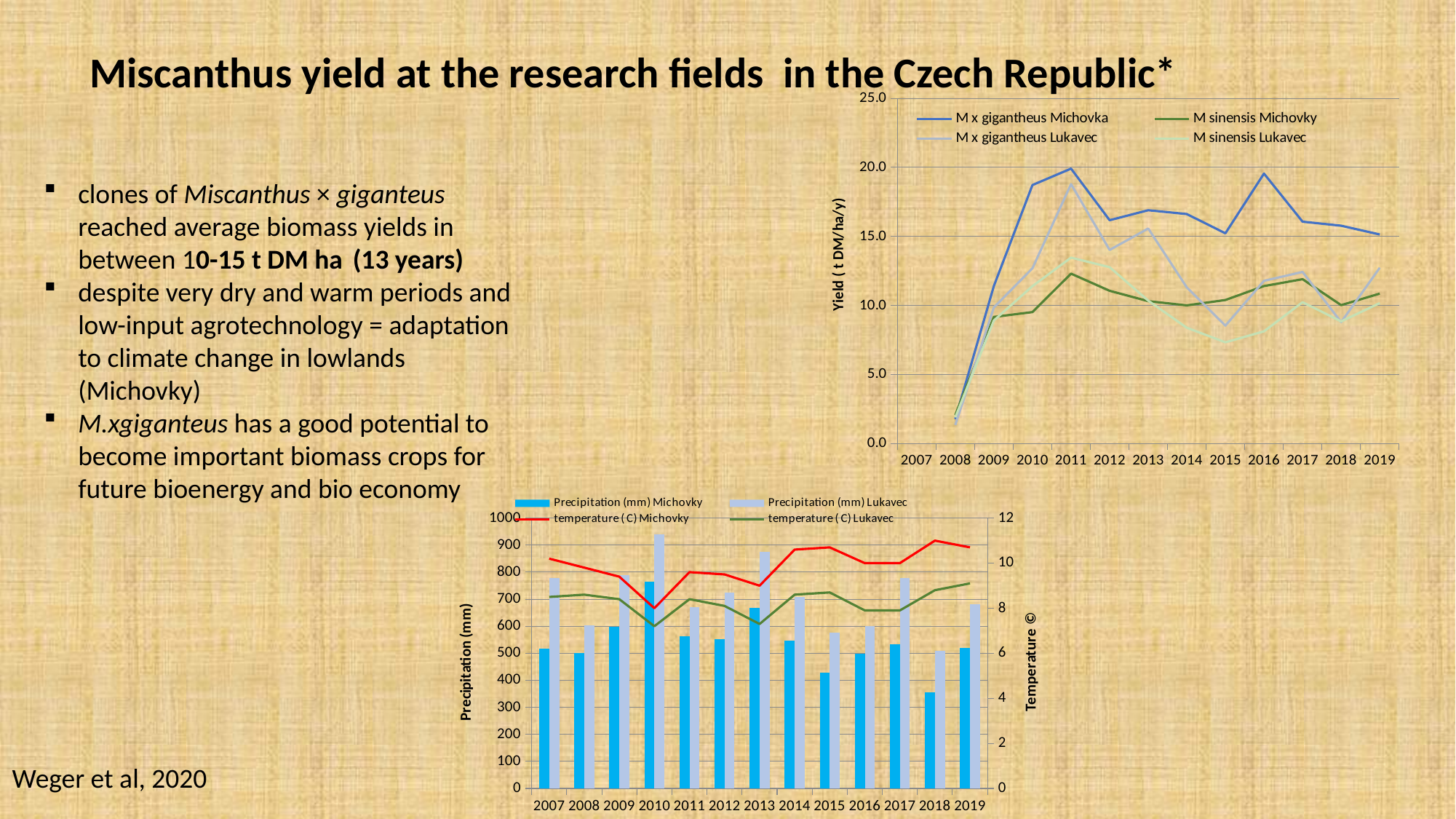
How many series does the legend of the bottom precipitation and temperature chart list? 4 What kind of chart is the top-right chart showing yield? line chart In the top-right yield chart, which series has the highest yield in 2016? M x gigantheus Michovka In the top-right yield chart, what is the label of the y axis? Yield ( t DM/ha/y) How many years are shown on the x axis of the bottom chart? 13 In the top-right yield chart, is the value for M sinensis Lukavec in 2015 greater or less than 10.0? less In the bottom chart, in which year is Precipitation (mm) Michovky lowest? 2018 In the top-right yield chart, is the value for M x gigantheus Michovka in 2010 greater or less than 15.0? greater In the bottom chart, which is larger: Precipitation (mm) Michovky in 2010 or in 2015? 2010 In the bottom chart, is the value for Precipitation (mm) Lukavec in 2010 greater or less than 900? greater In the bottom chart, in which year is Precipitation (mm) Lukavec highest? 2010 How many series does the legend of the top-right yield chart list? 4